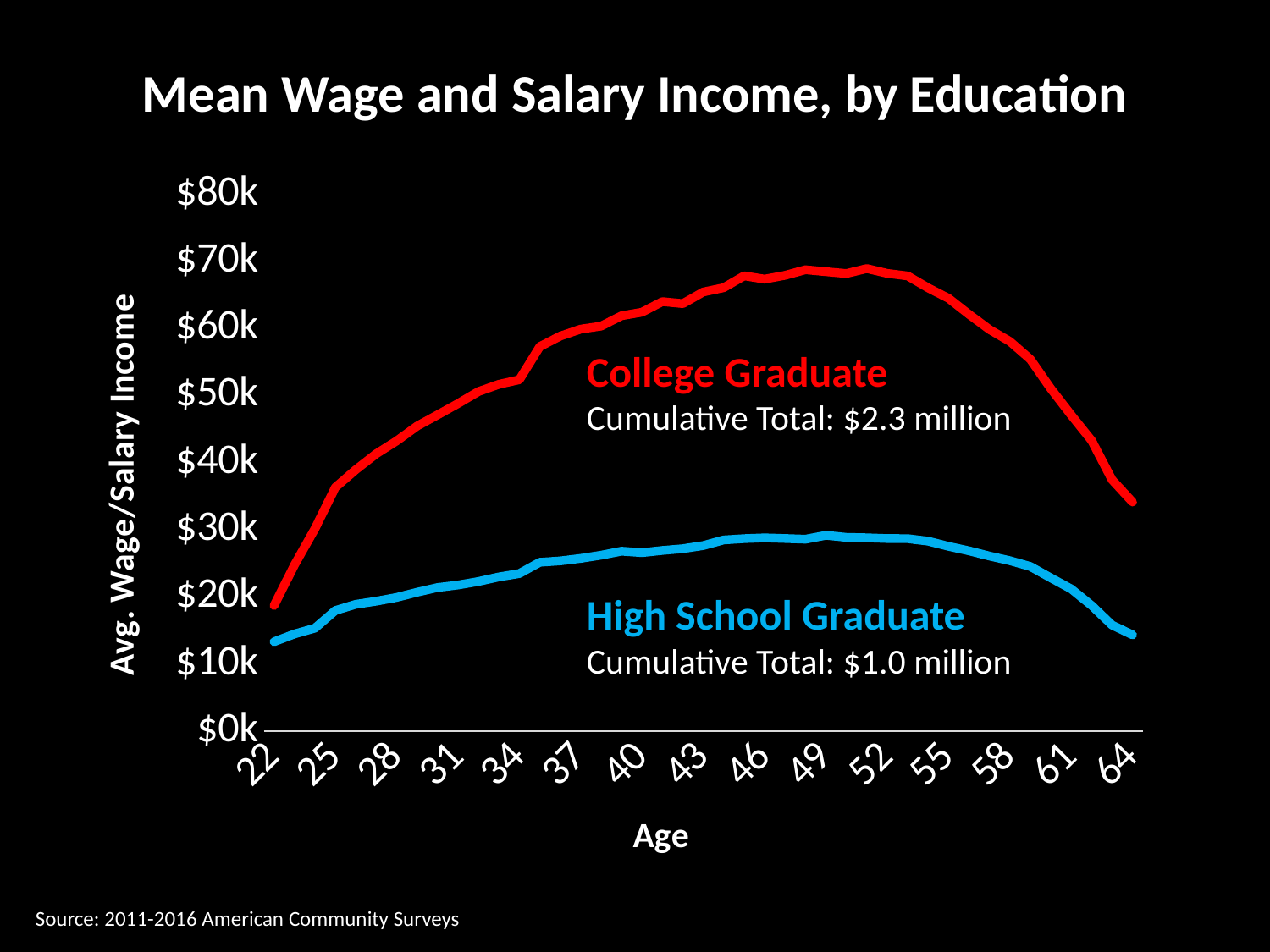
Which series has the higher cumulative total? College Graduate What is the title of the chart? Mean Wage and Salary Income, by Education How many series are plotted on the chart? 2 Does the College Graduate line rise or fall between age 52 and age 64? fall How many age labels are shown on the x axis? 15 What is the cumulative total shown for College Graduate? $2.3 million At age 40, which series has the higher average wage/salary income? College Graduate Is the College Graduate value at age 49 greater or less than $60k? greater What is the difference between the College Graduate and High School Graduate cumulative totals? $1.3 million What kind of chart is shown on the slide? line chart What is the cumulative total shown for High School Graduate? $1.0 million Is the High School Graduate value at age 22 greater or less than $20k? less